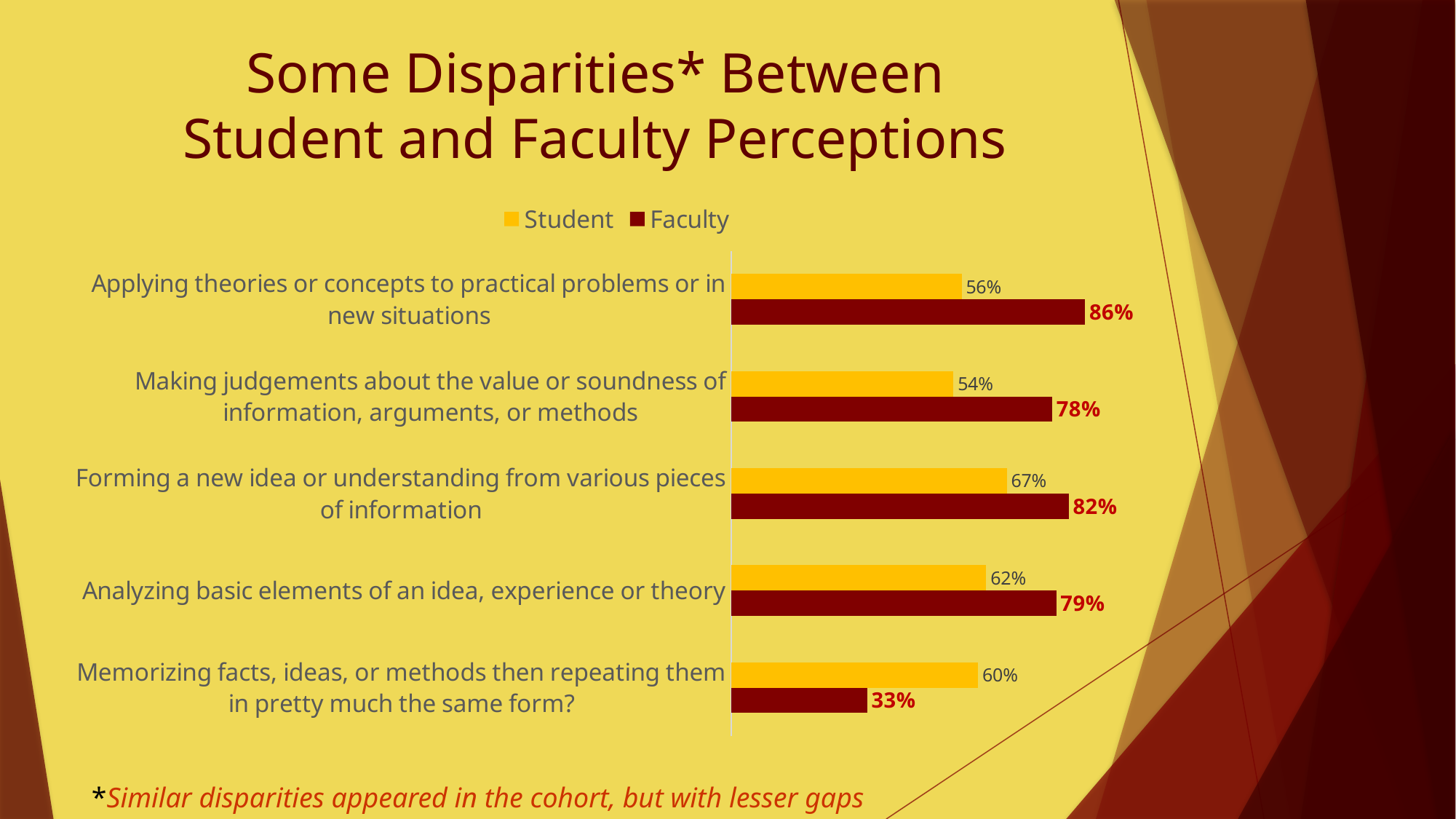
Which category has the lowest Student value? Making judgements about the value or soundness of information, arguments, or methods What kind of chart is shown on the slide? Bar chart What is the Student value for "Memorizing facts, ideas, or methods then repeating them in pretty much the same form?"? 60% What is the difference between the Faculty and Student values for "Applying theories or concepts to practical problems or in new situations"? 30% Which category has the highest Faculty value? Applying theories or concepts to practical problems or in new situations Which category has the lowest Faculty value? Memorizing facts, ideas, or methods then repeating them in pretty much the same form? What is the Faculty value for "Applying theories or concepts to practical problems or in new situations"? 86% For "Analyzing basic elements of an idea, experience or theory", which is larger, the Student value or the Faculty value? Faculty What is the Student value for "Forming a new idea or understanding from various pieces of information"? 67% How many categories are shown in the chart? 5 What is the difference between the Student and Faculty values for "Memorizing facts, ideas, or methods then repeating them in pretty much the same form?"? 27% How many series does the legend list? 2